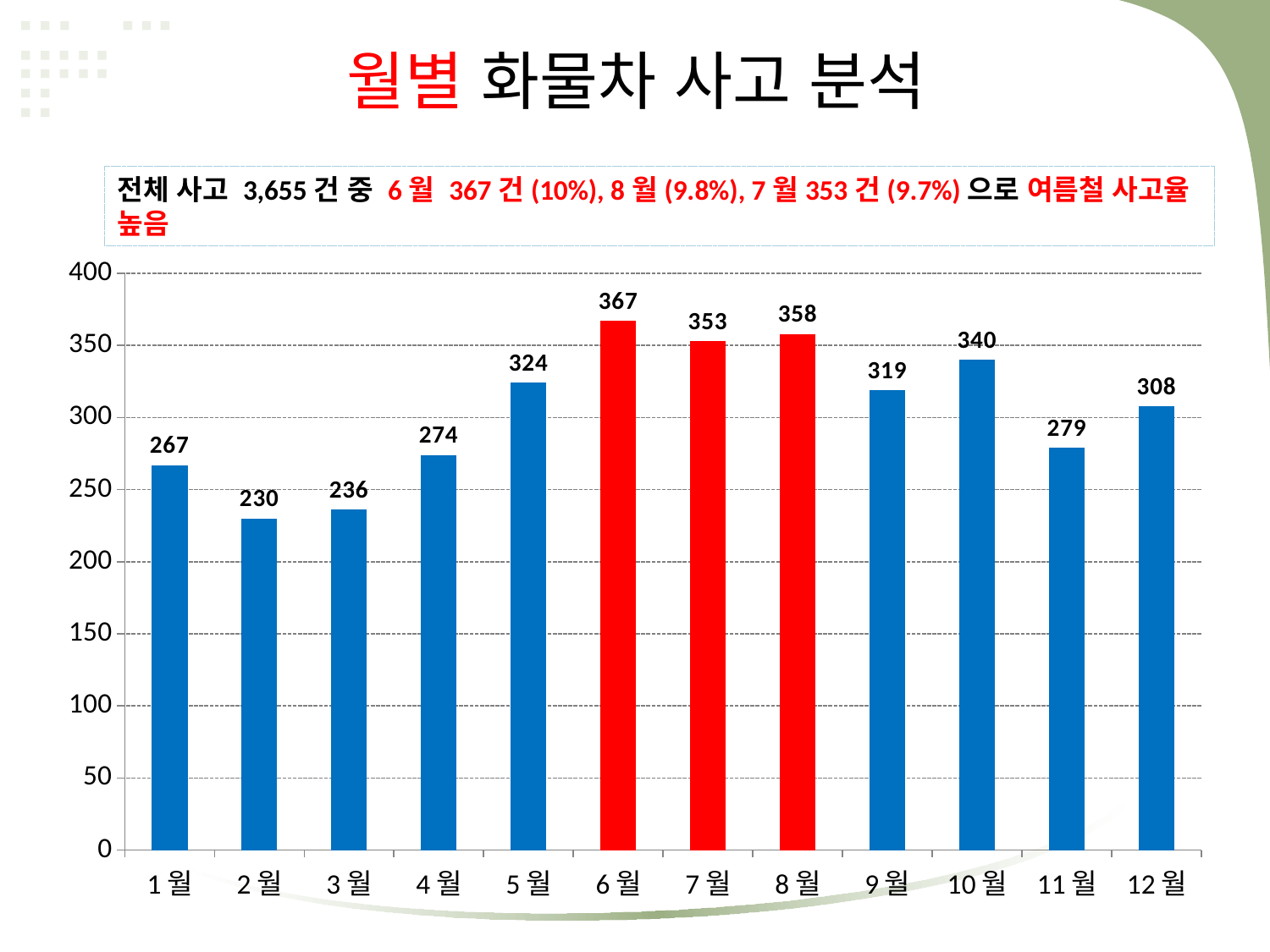
Is the value for 5월 greater or less than 300? greater Do the values rise or fall from 1월 to 2월? fall What is the value for 2월? 230 Which is larger, the value for 8월 or the value for 7월? 8월 How many months are shown on the x axis? 12 What is the difference between the values for 6월 and 2월? 137 Which month has the highest value? 6월 Which month has the lowest value? 2월 What kind of chart is shown on the slide? bar chart Which months are shown with red bars? 6월, 7월, 8월 What is the value for 10월? 340 What is the value for 6월? 367